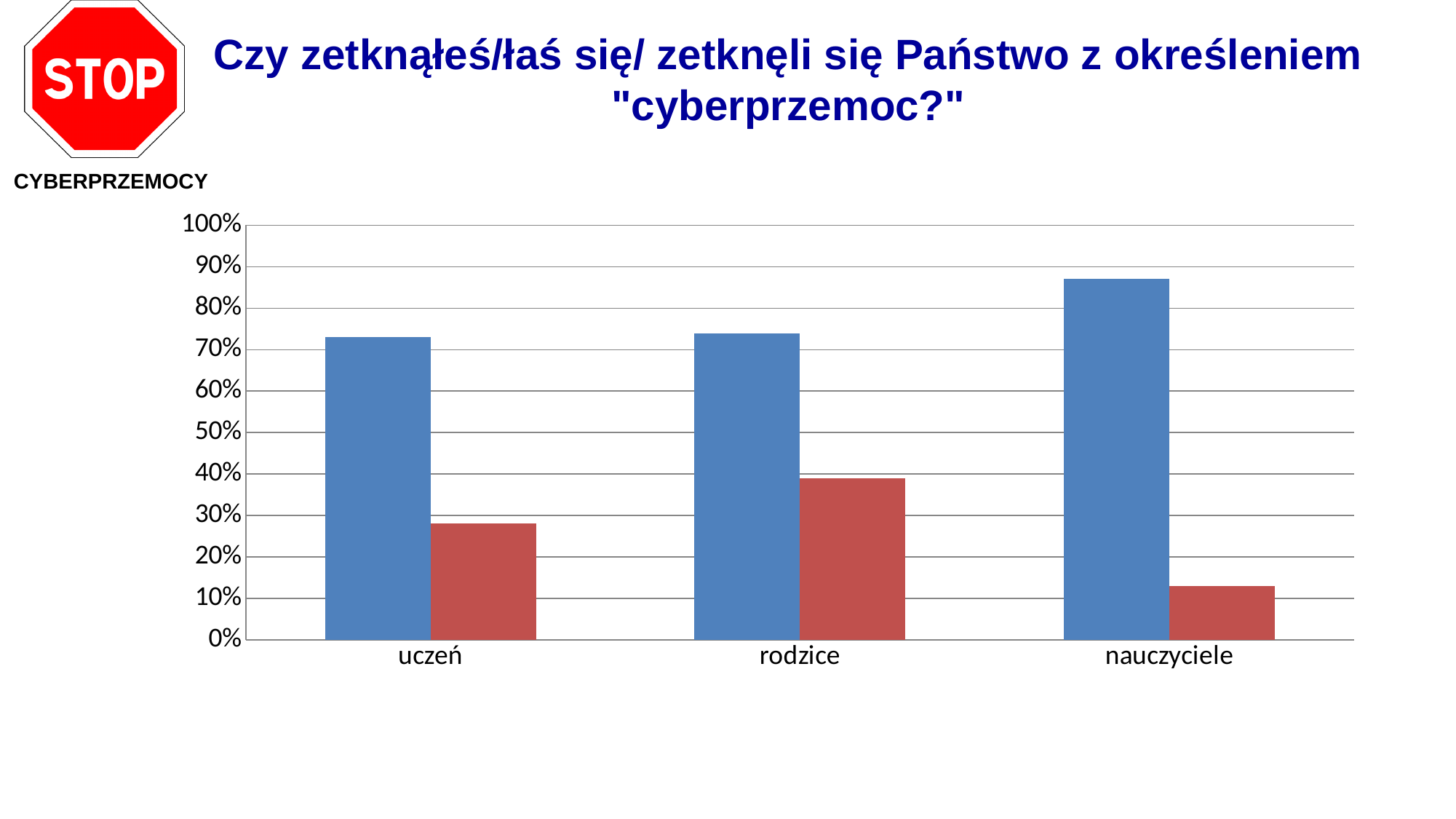
Which category has the tallest blue bar? nauczyciele Which category has the tallest red bar? rodzice Is the blue bar for uczeń greater or less than 70%? greater Is the red bar for nauczyciele greater or less than 20%? less Is the blue bar for nauczyciele greater or less than 80%? greater Which category has the shortest red bar? nauczyciele What is the highest value shown on the y axis of the chart? 100% What kind of chart is shown on the slide? bar chart For rodzice, which bar is taller, the blue one or the red one? the blue one How many categories are shown on the x axis of the chart? 3 Which is taller: the red bar for uczeń or the red bar for nauczyciele? the red bar for uczeń